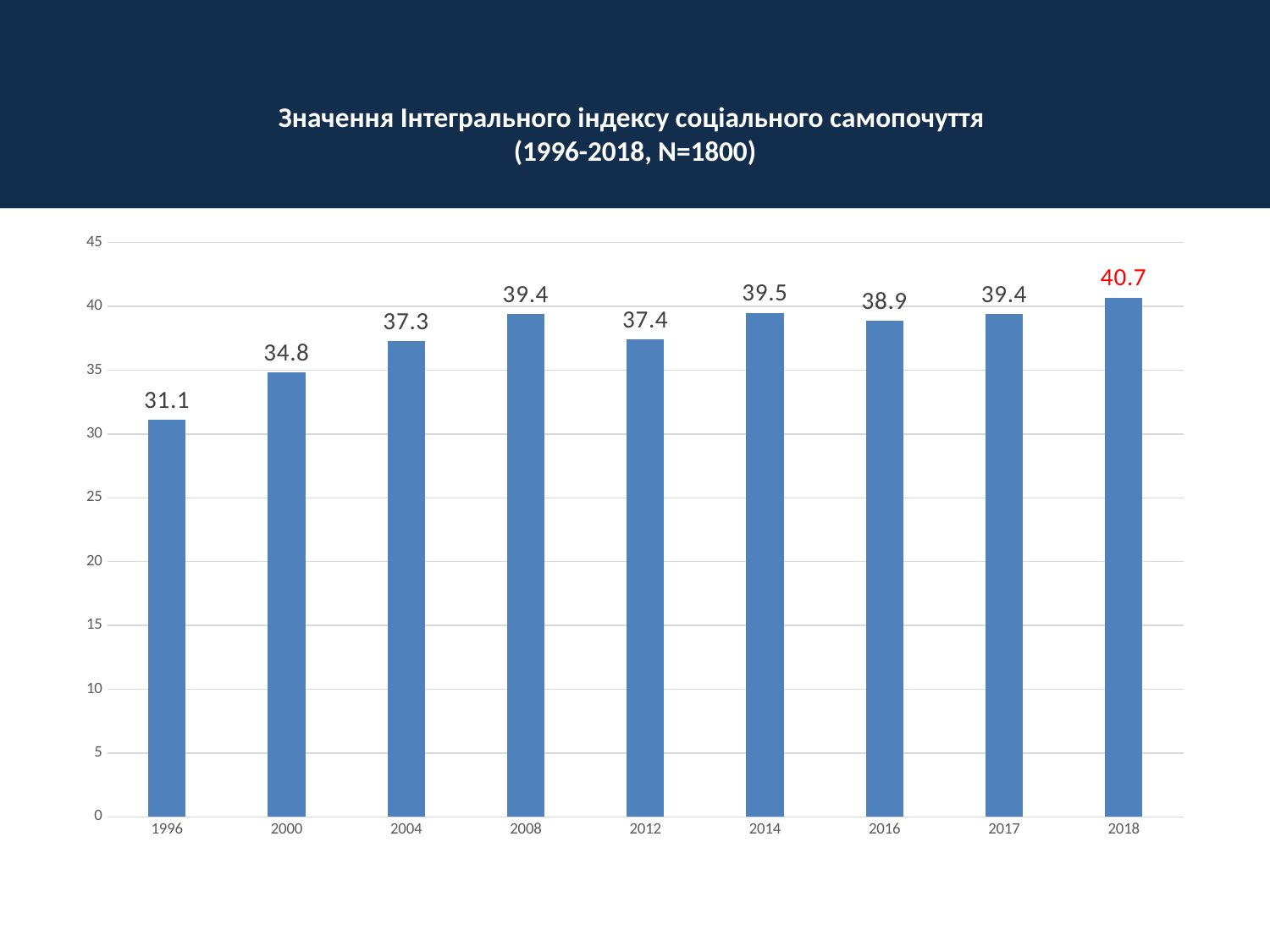
Which year has the lowest value? 1996 Which is larger, the value for 2004 or the value for 2012? 2012 What is the value of the index for 1996? 31.1 What is the difference between the values for 2018 and 1996? 9.6 Is the value for 2000 greater or less than 35? less What is the difference between the values for 2014 and 2016? 0.6 What kind of chart is shown on the slide? bar chart Which data label is shown in red? 40.7 (2018) How many years are shown on the x axis? 9 What is the value of the index for 2018? 40.7 What is the value of the index for 2012? 37.4 Which year has the highest value? 2018